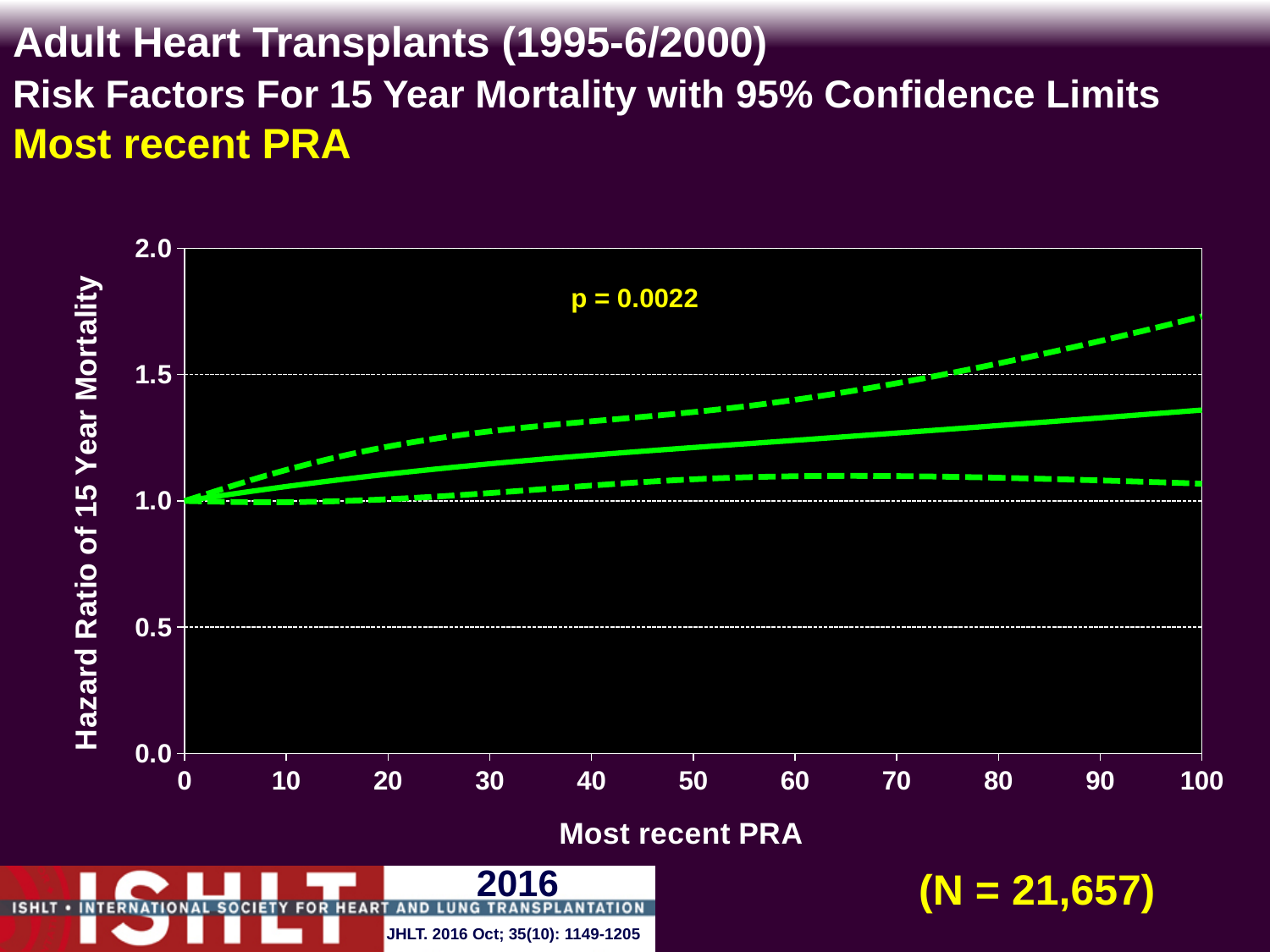
How many lines are plotted on the chart? 3 What kind of chart is shown on the slide? line chart What is the p-value printed on the chart? p = 0.0022 Is the lower dashed confidence limit at a Most recent PRA of 100 greater or less than 1.5? less What is the hazard ratio of the solid line at a Most recent PRA of 0? 1.0 Is the hazard ratio of the solid line at a Most recent PRA of 100 greater or less than 1.5? less What is the label of the y axis? Hazard Ratio of 15 Year Mortality Is the upper dashed confidence limit at a Most recent PRA of 50 greater or less than 1.5? less Does the solid hazard ratio line rise or fall as Most recent PRA increases from 0 to 100? rise